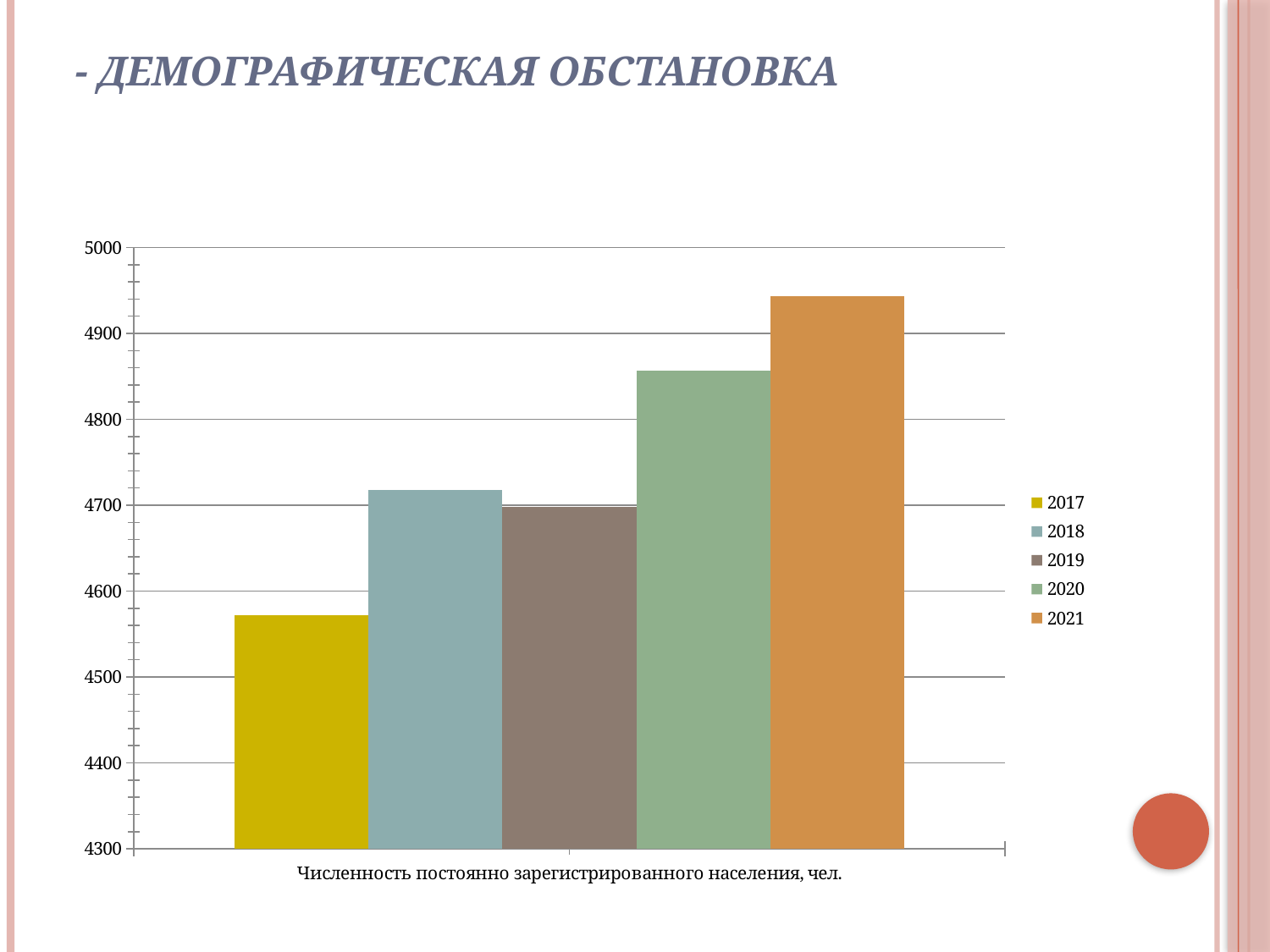
Is the value for 2017 greater or less than 4600? less What is the label of the category on the x axis? Численность постоянно зарегистрированного населения, чел. How many series does the legend list? 5 What kind of chart is shown on the slide? bar chart Which year has the lowest value for Численность постоянно зарегистрированного населения? 2017 Which year has the highest value for Численность постоянно зарегистрированного населения? 2021 Is the value for 2021 greater or less than 4900? greater Which is larger, the value for 2020 or the value for 2019? 2020 Is the value for 2020 greater or less than 4800? greater How many categories are shown on the x axis? 1 Which is larger, the value for 2017 or the value for 2018? 2018